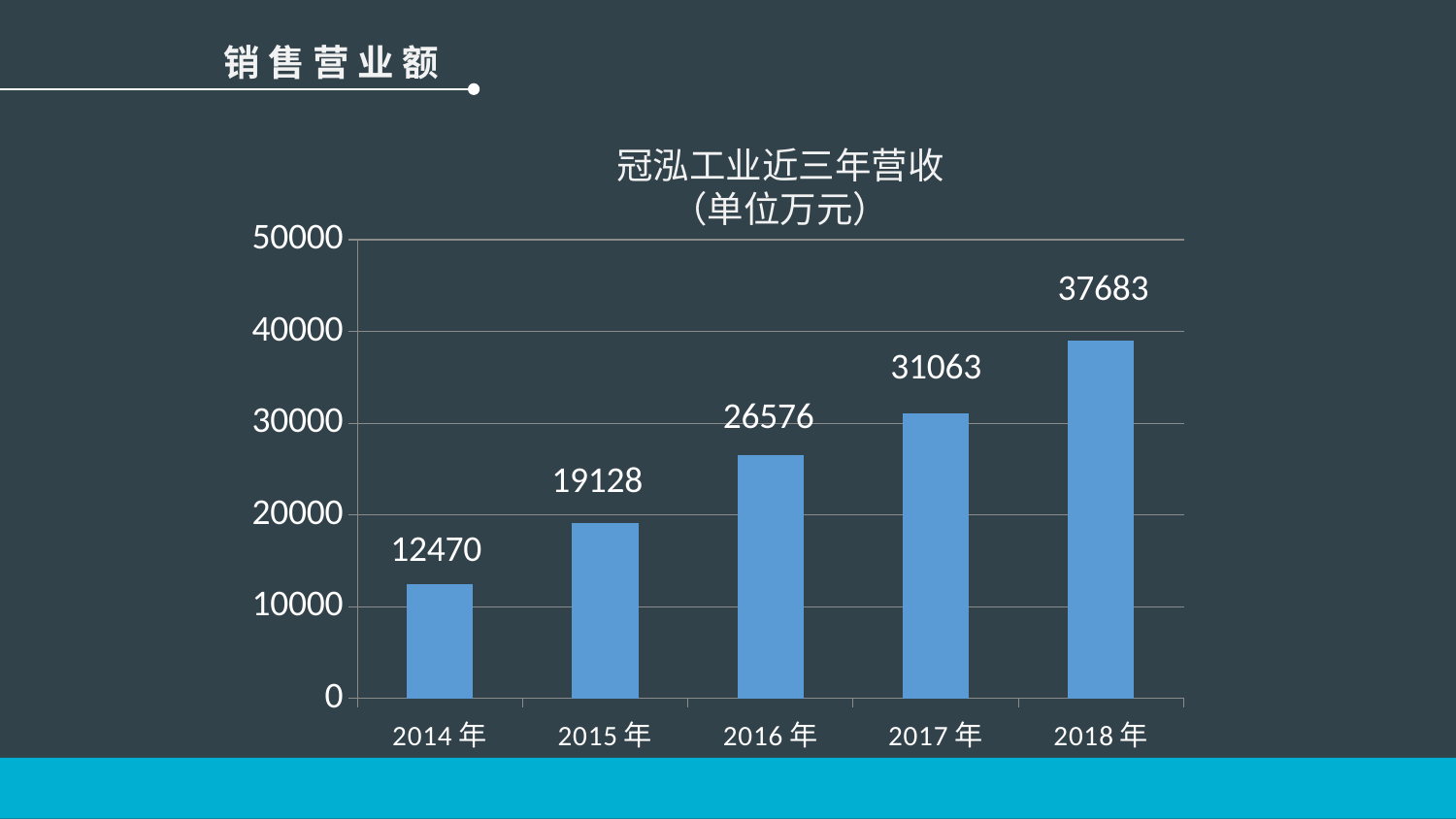
Do the values rise or fall from 2014 年 to 2018 年? rise What kind of chart is this? bar chart What is the difference between the values for 2015 年 and 2014 年? 6658 What is the value for 2016 年? 26576 What is the value for 2018 年? 37683 Is the value for 2017 年 greater or less than 30000? greater How many years are shown on the x axis? 5 What is the difference between the values for 2018 年 and 2017 年? 6620 Which is larger, the value for 2016 年 or the value for 2017 年? 2017 年 What is the value for 2014 年? 12470 Which year has the lowest value? 2014 年 Which year has the highest value? 2018 年